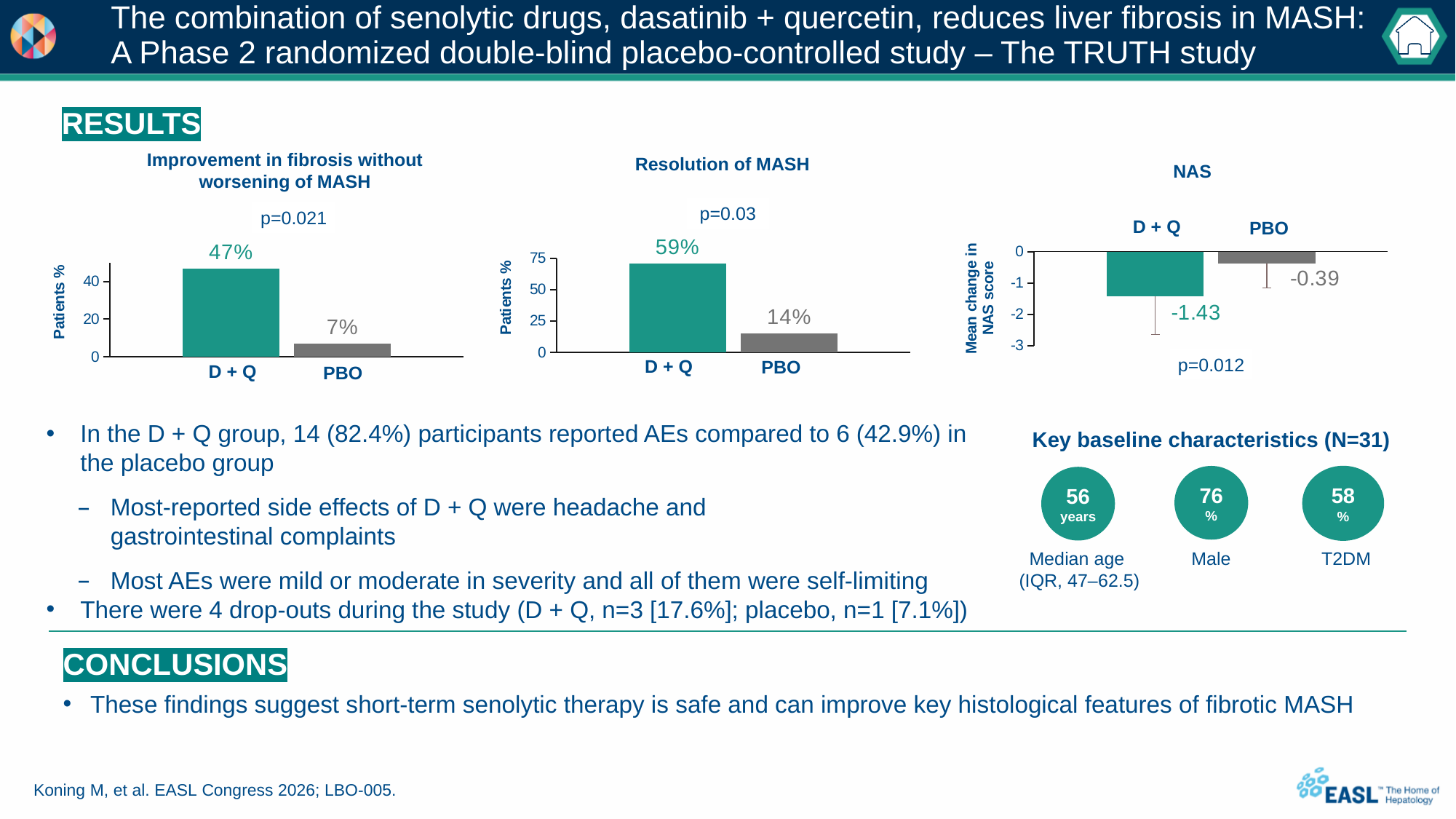
In the 'NAS' chart, which group shows the larger decrease in NAS score? D + Q In the 'NAS' chart, what is the mean change in NAS score for PBO? -0.39 In the 'Improvement in fibrosis without worsening of MASH' chart, what is the value for D + Q? 47% In the 'NAS' chart, what is the mean change in NAS score for D + Q? -1.43 What type of chart is the 'Resolution of MASH' chart? Bar chart In the 'Resolution of MASH' chart, what is the value for PBO? 14% In the 'Resolution of MASH' chart, what is the value for D + Q? 59% How many groups are plotted in the 'Improvement in fibrosis without worsening of MASH' chart? 2 In the 'Improvement in fibrosis without worsening of MASH' chart, what is the difference between the D + Q and PBO values? 40% In the 'Resolution of MASH' chart, which group has the higher value? D + Q In the 'Improvement in fibrosis without worsening of MASH' chart, what is the value for PBO? 7% In the 'Resolution of MASH' chart, is the value for D + Q greater or less than 50? greater